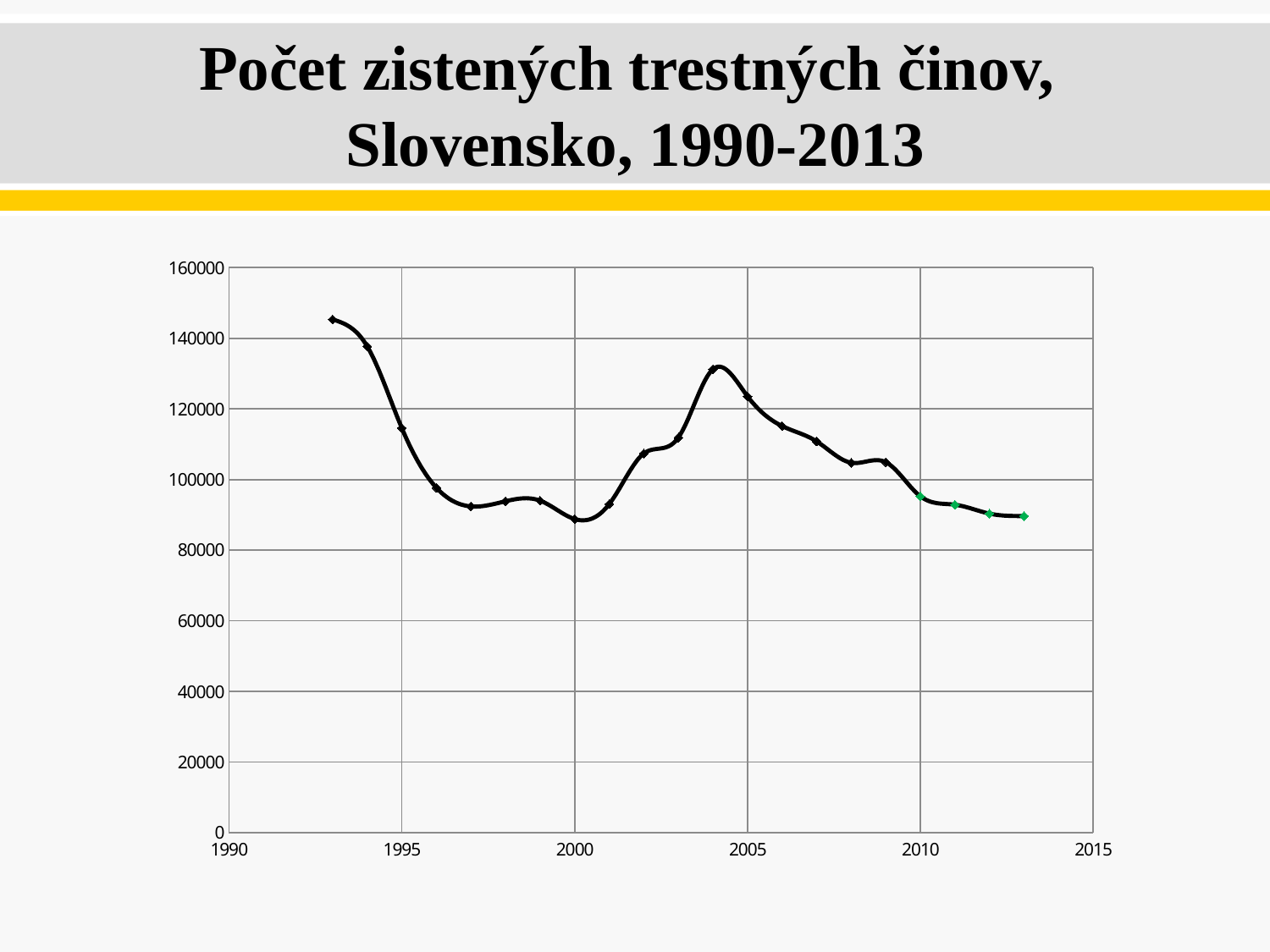
What kind of chart is shown on the slide? line chart Is the value for 2004 greater or less than 120000? greater Which year has the larger value, 1993 or 2004? 1993 Is the value for 2010 greater or less than 100000? less Do the values rise or fall between 2004 and 2013? fall Is the value for 1993 greater or less than 140000? greater In which year is the plotted value highest? 1993 What is the title of the chart? Počet zistených trestných činov, Slovensko, 1990-2013 Do the values rise or fall between 2000 and 2004? rise Which year has the larger value, 1996 or 2002? 2002